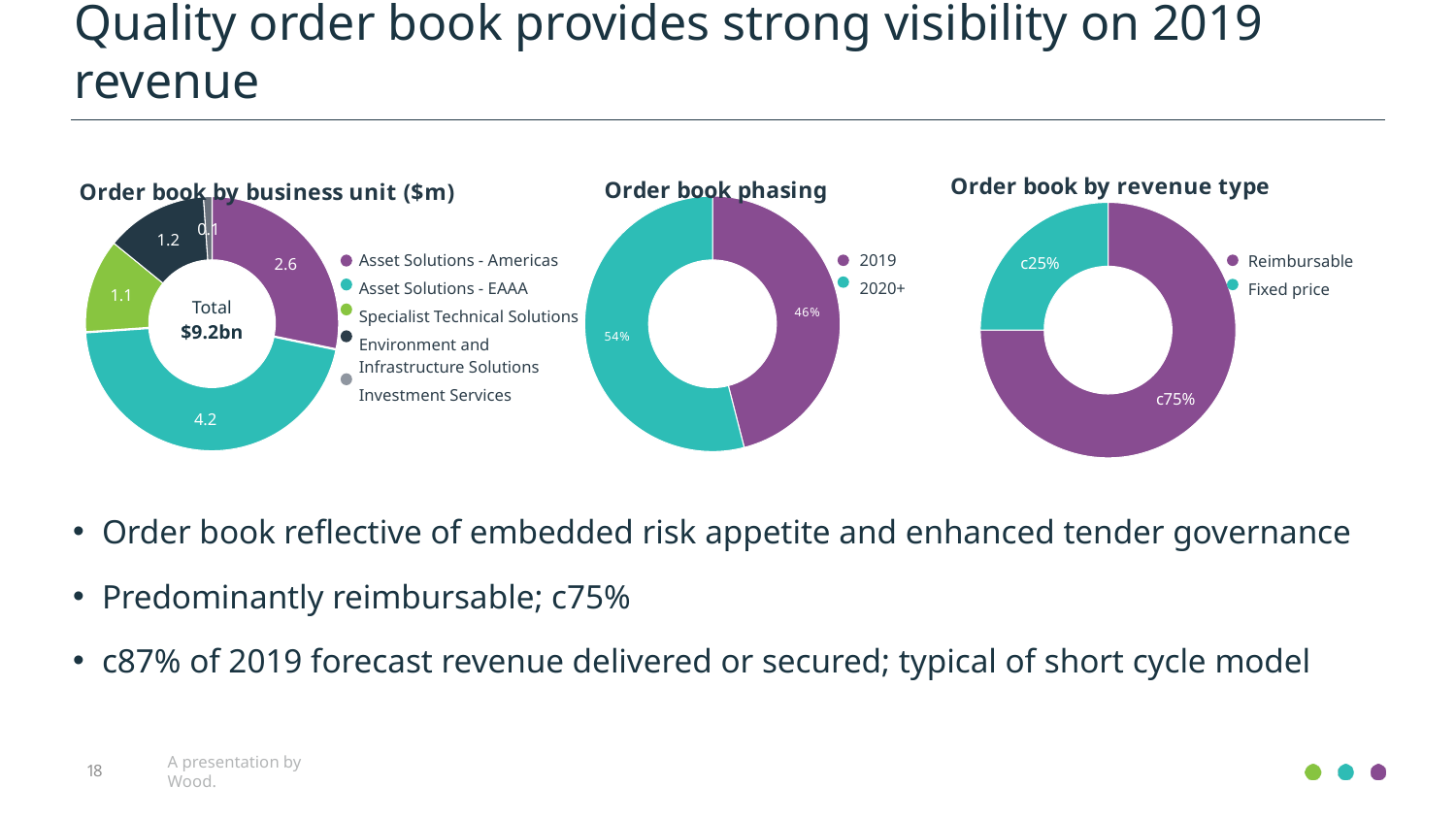
In the 'Order book phasing' chart, what share of the order book is for 2019? 46% In the 'Order book by business unit ($m)' chart, which is larger: Environment and Infrastructure Solutions or Specialist Technical Solutions? Environment and Infrastructure Solutions What kind of chart is the 'Order book by revenue type' chart? Donut (pie) chart In the 'Order book by business unit ($m)' chart, which business unit has the smallest value? Investment Services In the 'Order book by business unit ($m)' chart, what is the difference between Asset Solutions - EAAA and Asset Solutions - Americas? 1.6 In the 'Order book by business unit ($m)' chart, what is the value for Asset Solutions - Americas? 2.6 How many business units are shown in the 'Order book by business unit ($m)' chart? 5 In the 'Order book by business unit ($m)' chart, what is the value for Asset Solutions - EAAA? 4.2 What total is shown in the centre of the 'Order book by business unit ($m)' chart? $9.2bn In the 'Order book by business unit ($m)' chart, which business unit has the largest value? Asset Solutions - EAAA In the 'Order book phasing' chart, what share of the order book is for 2020+? 54% In the 'Order book by revenue type' chart, what share is Reimbursable? c75%